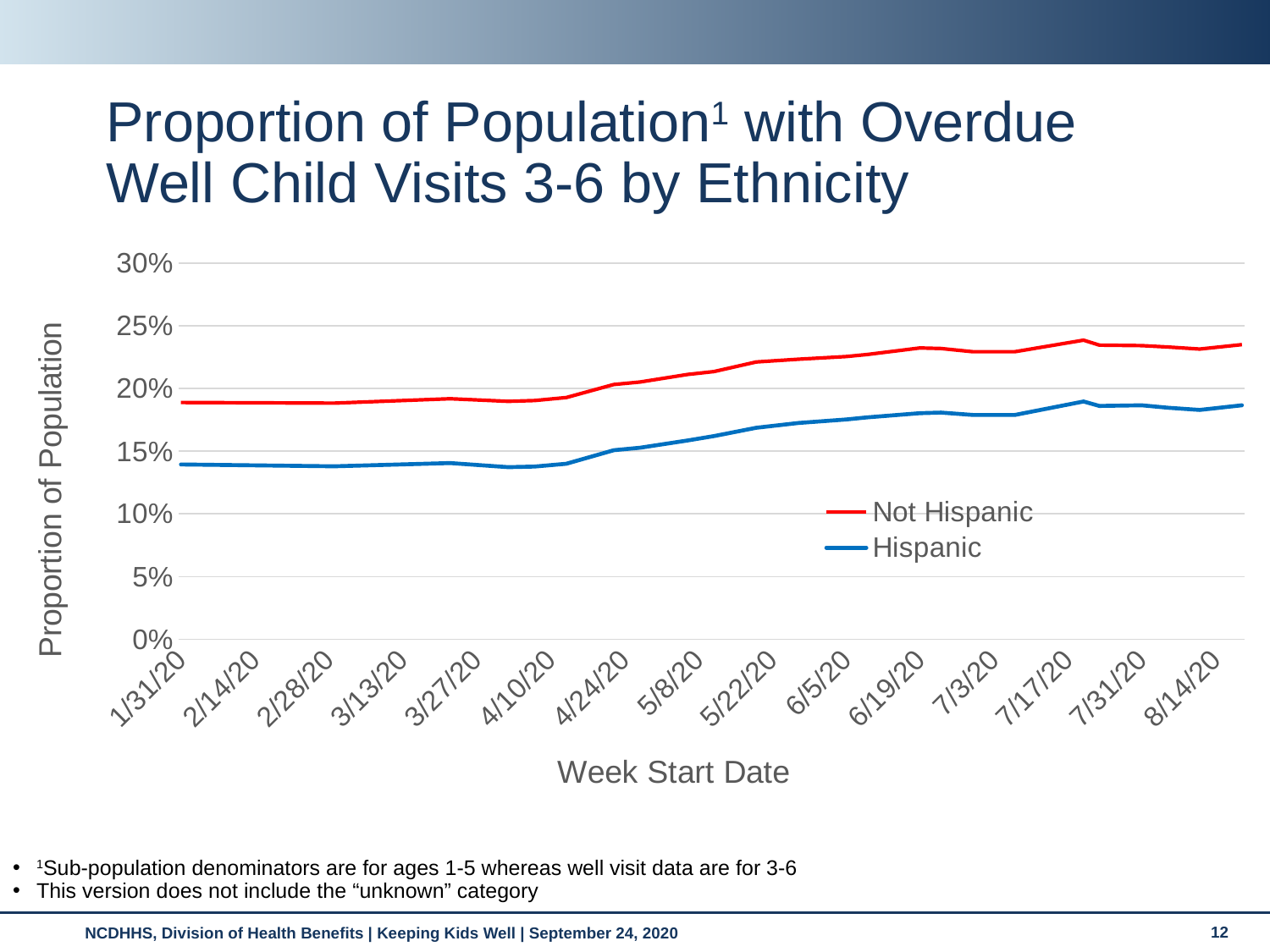
How many series does the legend list? 2 Is the value for Hispanic at 8/14/20 greater or less than 15%? greater Is the value for Hispanic at 1/31/20 greater or less than 15%? less Is the value for Not Hispanic at 8/14/20 greater or less than 20%? greater Does the Hispanic line generally rise or fall from 1/31/20 to 8/14/20? Rise Which series is plotted in red? Not Hispanic Does the Not Hispanic line generally rise or fall from 1/31/20 to 8/14/20? Rise What is the label of the x axis? Week Start Date Which series has the higher value at 8/14/20, Not Hispanic or Hispanic? Not Hispanic What kind of chart is shown on the slide? Line chart Which series has the lower value at 1/31/20, Not Hispanic or Hispanic? Hispanic